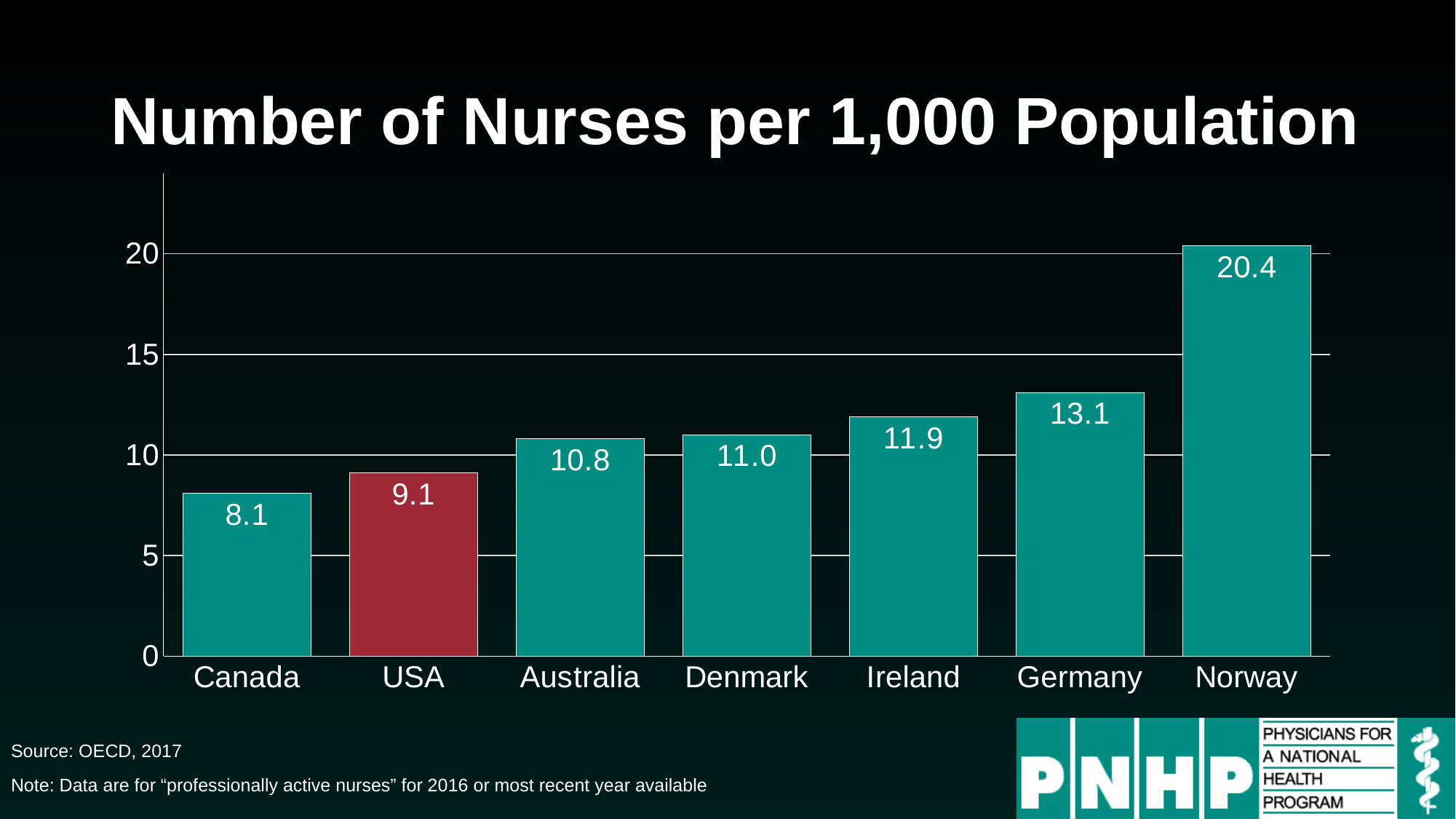
What is the number of nurses per 1,000 population for the USA? 9.1 How many countries are shown in the chart? 7 What is the number of nurses per 1,000 population for Norway? 20.4 Which country has the highest number of nurses per 1,000 population? Norway What kind of chart is shown on the slide? Bar chart Which country's bar is coloured red instead of teal? USA What is the value shown for Denmark? 11.0 Is the value for Germany greater or less than 15? less Which country has the lowest number of nurses per 1,000 population? Canada Which has a higher value, Ireland or Australia? Ireland What is the difference between Germany's and Canada's values? 5.0 What is the difference between Norway's and the USA's values? 11.3